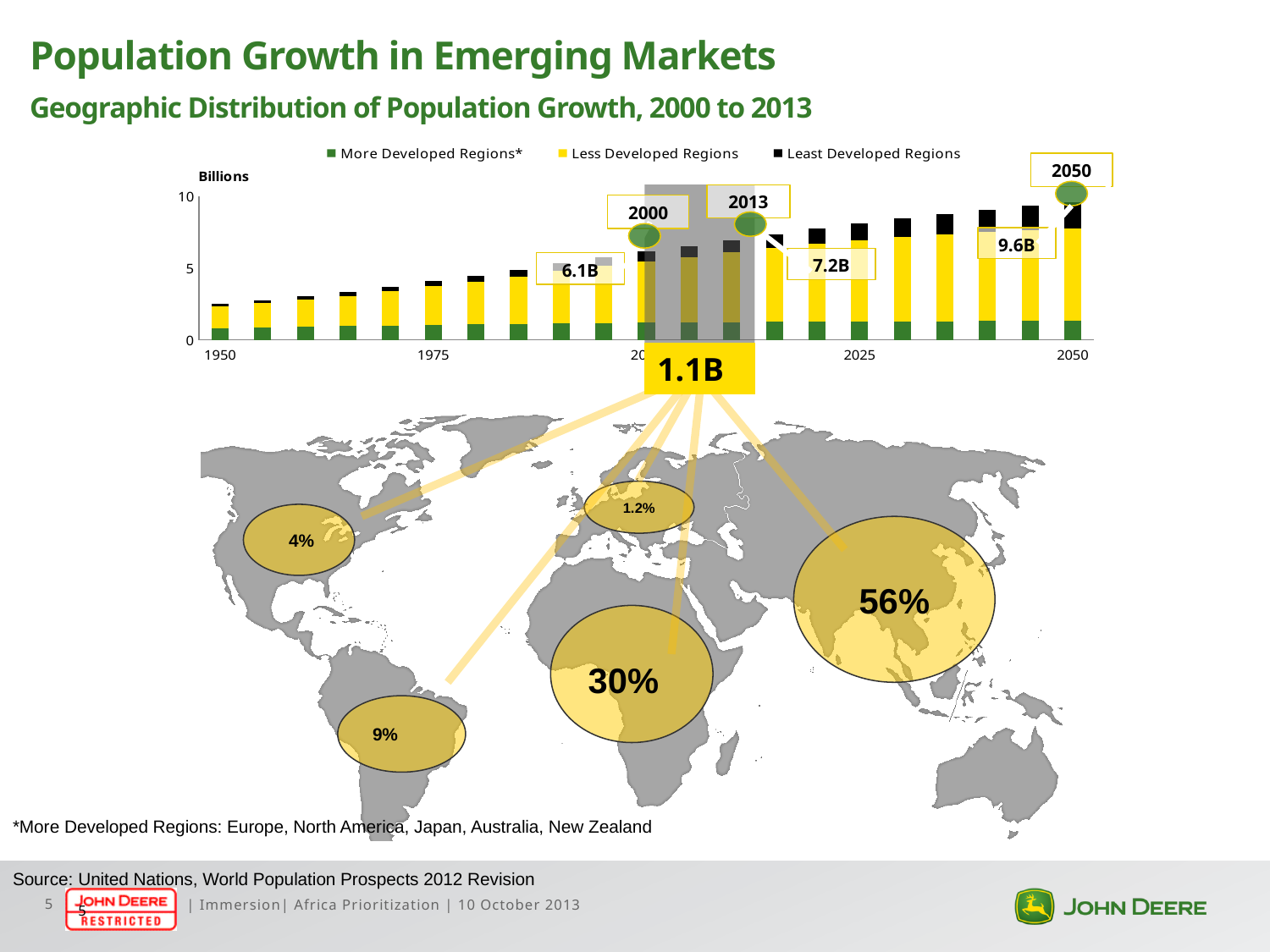
On the map, what percentage is shown in the ellipse over Asia? 56% On the map, what percentage is shown in the ellipse over Africa? 30% What total world population is labelled for the year 2000 on the chart? 6.1B Do the stacked bars rise or fall from 1950 to 2050? rise What total world population is labelled for the year 2050 on the chart? 9.6B Is the total height of the 1950 bar greater or less than 5 billion? less What total world population is labelled for the year 2013 on the chart? 7.2B What kind of chart is shown at the top of the slide? bar chart By how much did the labelled world population grow between 2000 and 2013? 1.1B What is the difference between the labelled population for 2050 and for 2013? 2.4B How many series does the legend of the population chart list? 3 Is the total height of the 2025 bar greater or less than 5 billion? greater